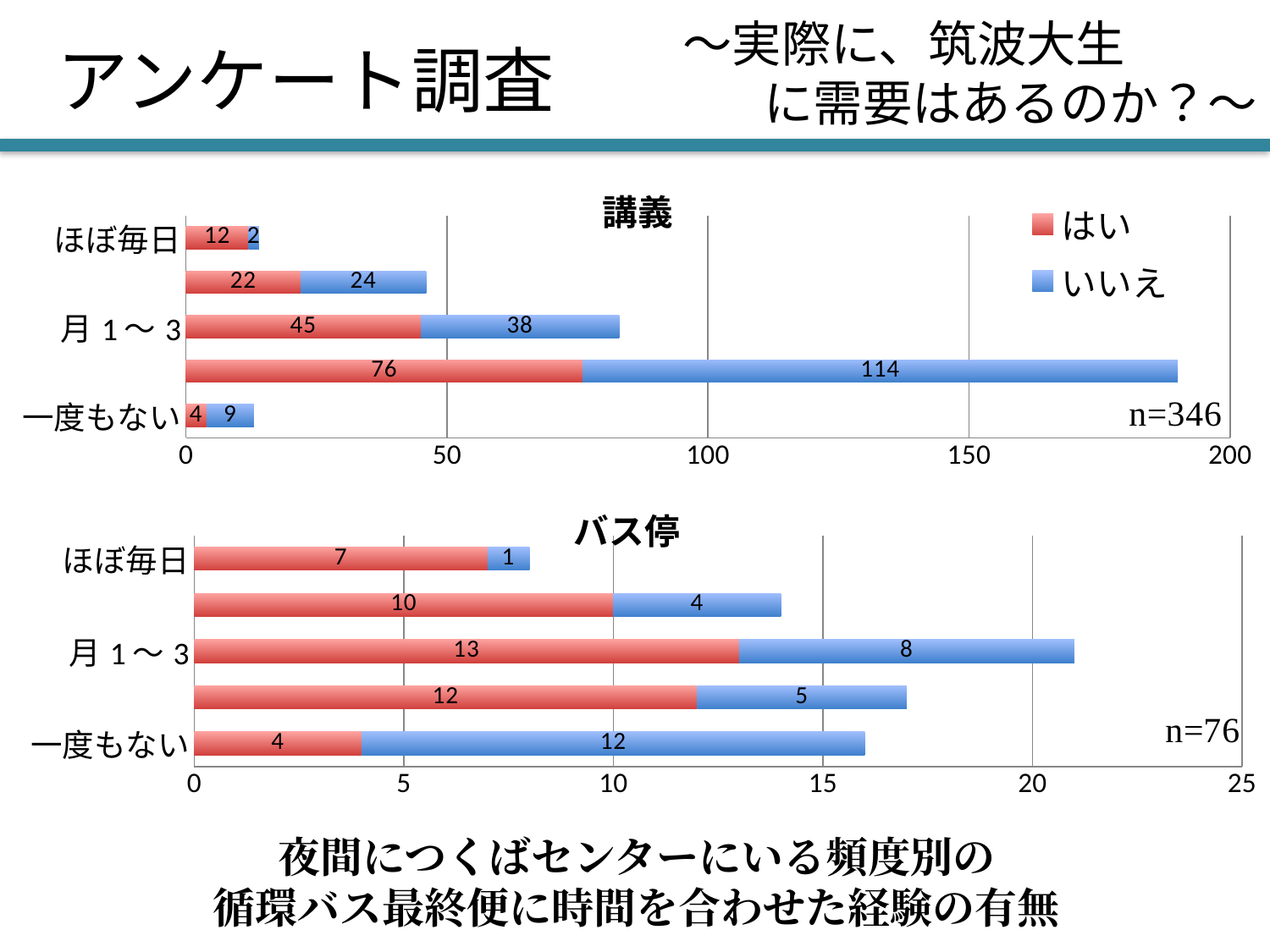
In the バス停 chart, what is the いいえ value for 一度もない? 12 In the バス停 chart, which is larger for 一度もない, はい or いいえ? いいえ What kind of chart is the バス停 chart? Stacked bar chart How many series does the legend of the 講義 chart list? 2 In the 講義 chart, what is the total of the stacked bar for ほぼ毎日? 14 What colour represents はい in the charts? Red In the 講義 chart, which is larger for ほぼ毎日, はい or いいえ? はい In the 講義 chart, what is the はい value for 月１〜３? 45 In the バス停 chart, what is the total of the stacked bar for 月１〜３? 21 In the 講義 chart, what is the いいえ value for 一度もない? 9 In the バス停 chart, what is the はい value for ほぼ毎日? 7 In the 講義 chart, what is the difference between the はい and いいえ values for 月１〜３? 7